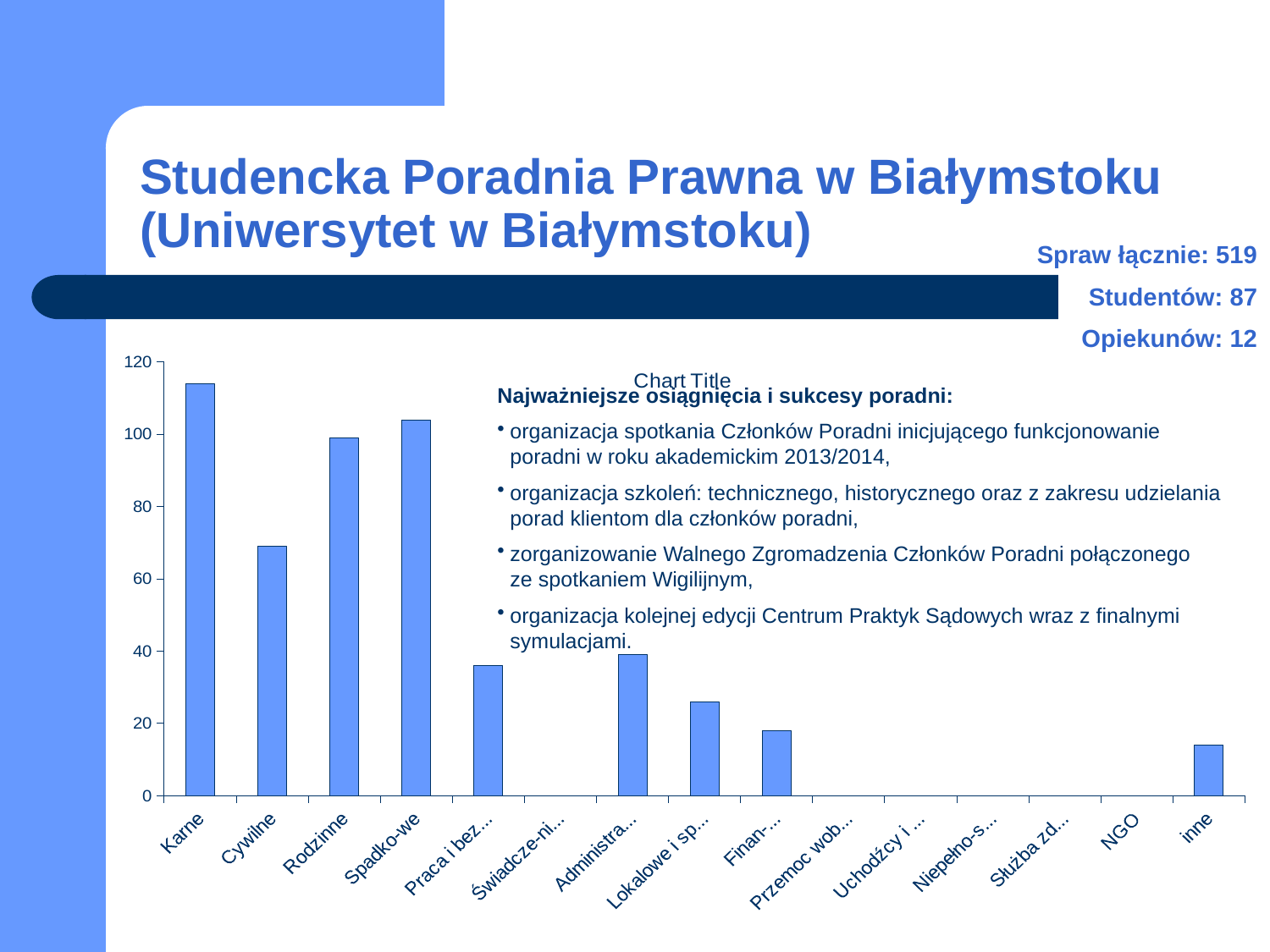
Is the value for Cywilne greater or less than 80? less Which is larger, the value for Cywilne or the value for Rodzinne? Rodzinne Is the value for Karne greater or less than 100? greater Is the value for inne greater or less than 20? less Which is larger, the value for Karne or the value for Cywilne? Karne What kind of chart is shown on the slide? bar chart What is the title shown on the chart? Chart Title Which category has the highest bar in the chart? Karne How many categories are shown on the x axis of the chart? 15